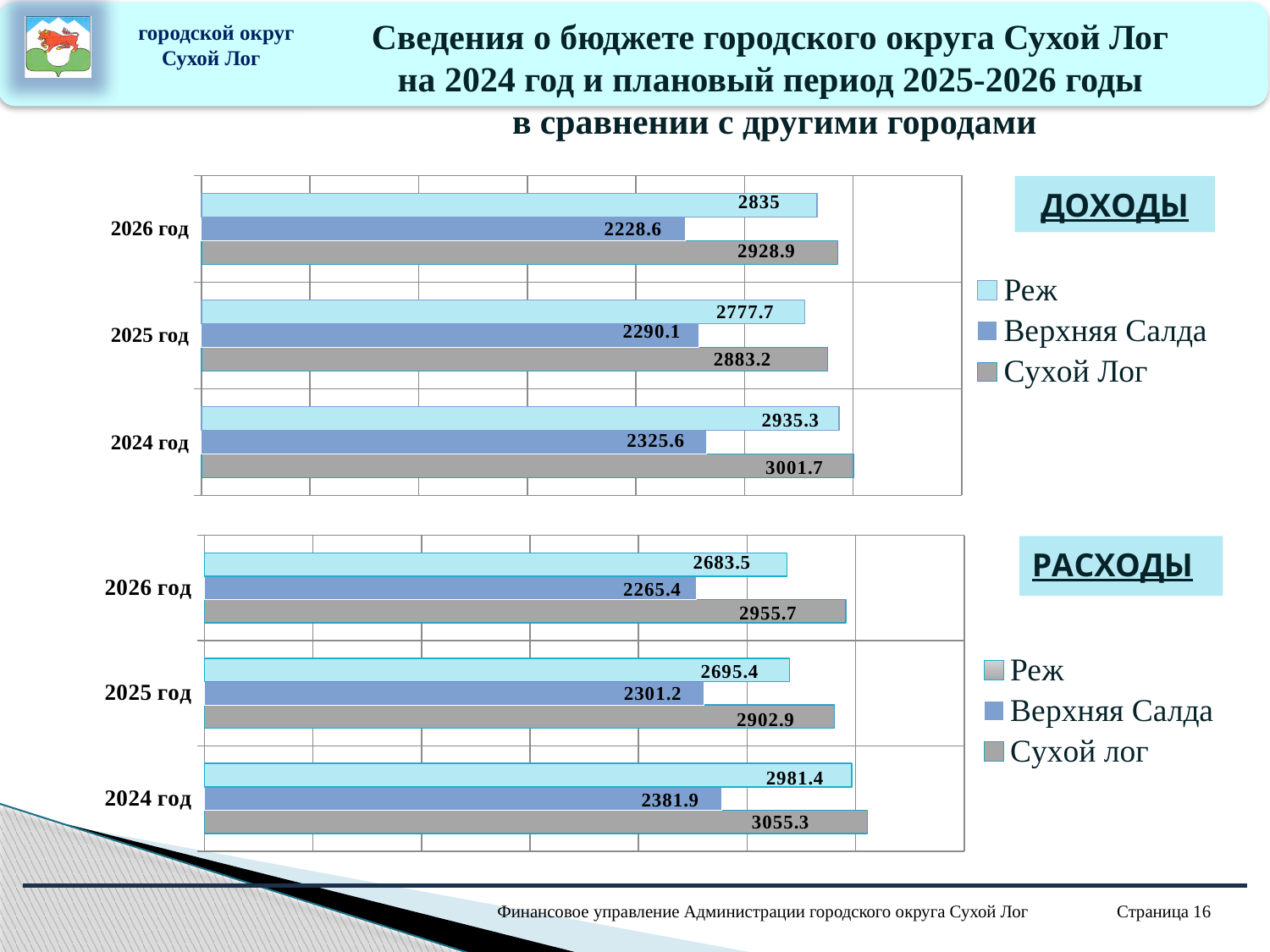
In the ДОХОДЫ chart, what is the value for Сухой Лог in 2024 год? 3001.7 In the РАСХОДЫ chart, which city has the lowest value in 2024 год? Верхняя Салда How many year categories are shown in the РАСХОДЫ chart? 3 In the ДОХОДЫ chart, what is the value for Верхняя Салда in 2026 год? 2228.6 What type of chart is the ДОХОДЫ chart? Bar chart In the РАСХОДЫ chart, what is the value for Реж in 2025 год? 2695.4 In the РАСХОДЫ chart, which is larger: Реж in 2026 год or Реж in 2025 год? Реж in 2025 год In the РАСХОДЫ chart, what is the difference between Реж and Верхняя Салда in 2024 год? 599.5 In the ДОХОДЫ chart, what is the difference between Сухой Лог and Реж in 2026 год? 93.9 In the РАСХОДЫ chart, what is the value for Сухой лог in 2026 год? 2955.7 In the ДОХОДЫ chart, which city has the highest value in 2025 год? Сухой Лог How many series does the legend of the ДОХОДЫ chart list? 3